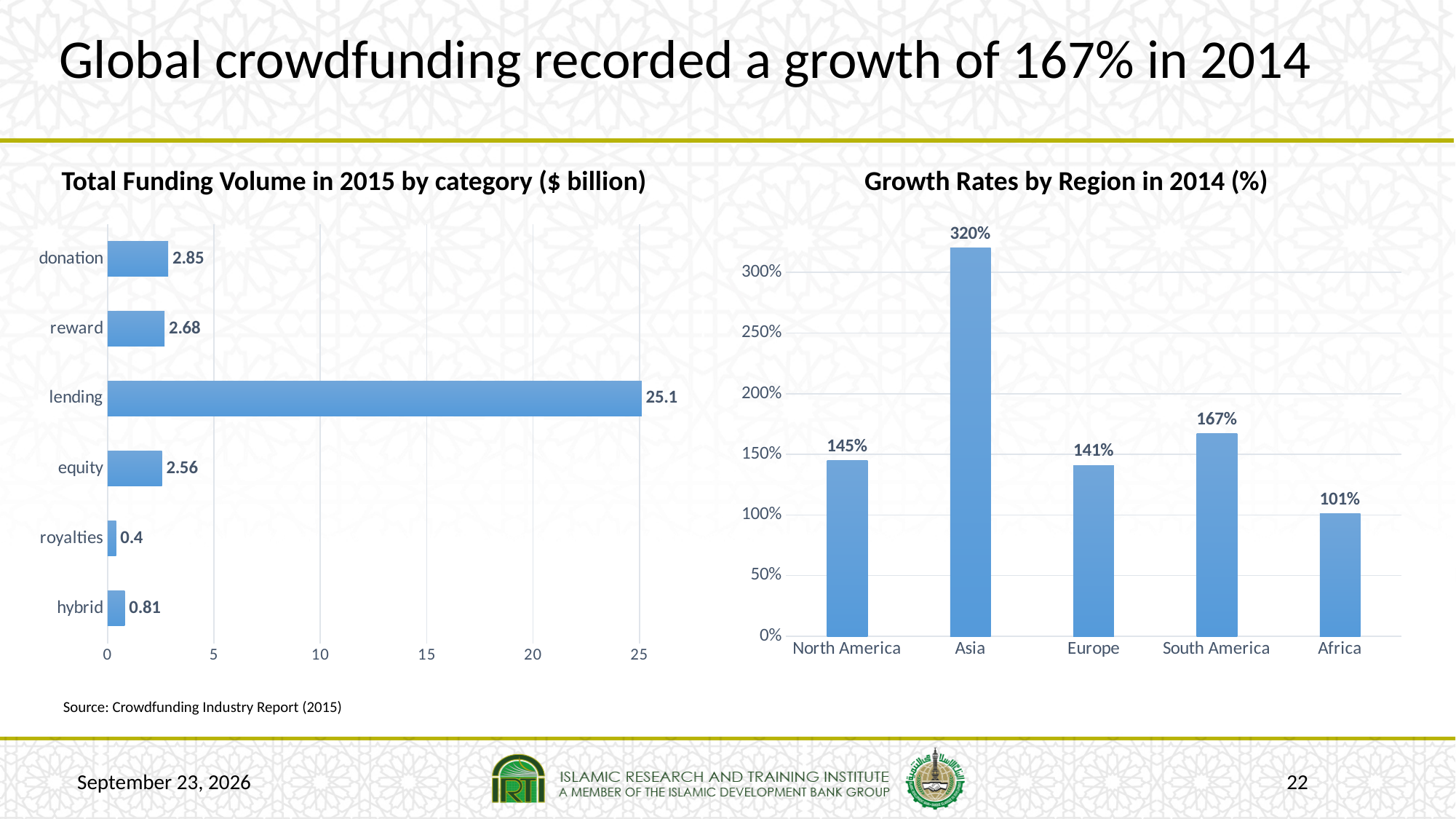
In the 'Total Funding Volume in 2015 by category ($ billion)' chart, what is the value for lending? 25.1 In the 'Growth Rates by Region in 2014 (%)' chart, how many regions are shown? 5 In the 'Growth Rates by Region in 2014 (%)' chart, which region has the lowest growth rate? Africa In the 'Total Funding Volume in 2015 by category ($ billion)' chart, how many categories are shown? 6 What kind of chart is the 'Total Funding Volume in 2015 by category ($ billion)' chart? bar chart In the 'Total Funding Volume in 2015 by category ($ billion)' chart, what is the value for royalties? 0.4 In the 'Total Funding Volume in 2015 by category ($ billion)' chart, which is larger, equity or hybrid? equity In the 'Growth Rates by Region in 2014 (%)' chart, what is the difference between South America and Europe? 26% In the 'Total Funding Volume in 2015 by category ($ billion)' chart, which category has the lowest value? royalties In the 'Growth Rates by Region in 2014 (%)' chart, which is larger, North America or Europe? North America In the 'Total Funding Volume in 2015 by category ($ billion)' chart, what is the difference between donation and reward? 0.17 In the 'Growth Rates by Region in 2014 (%)' chart, what is the value for Asia? 320%